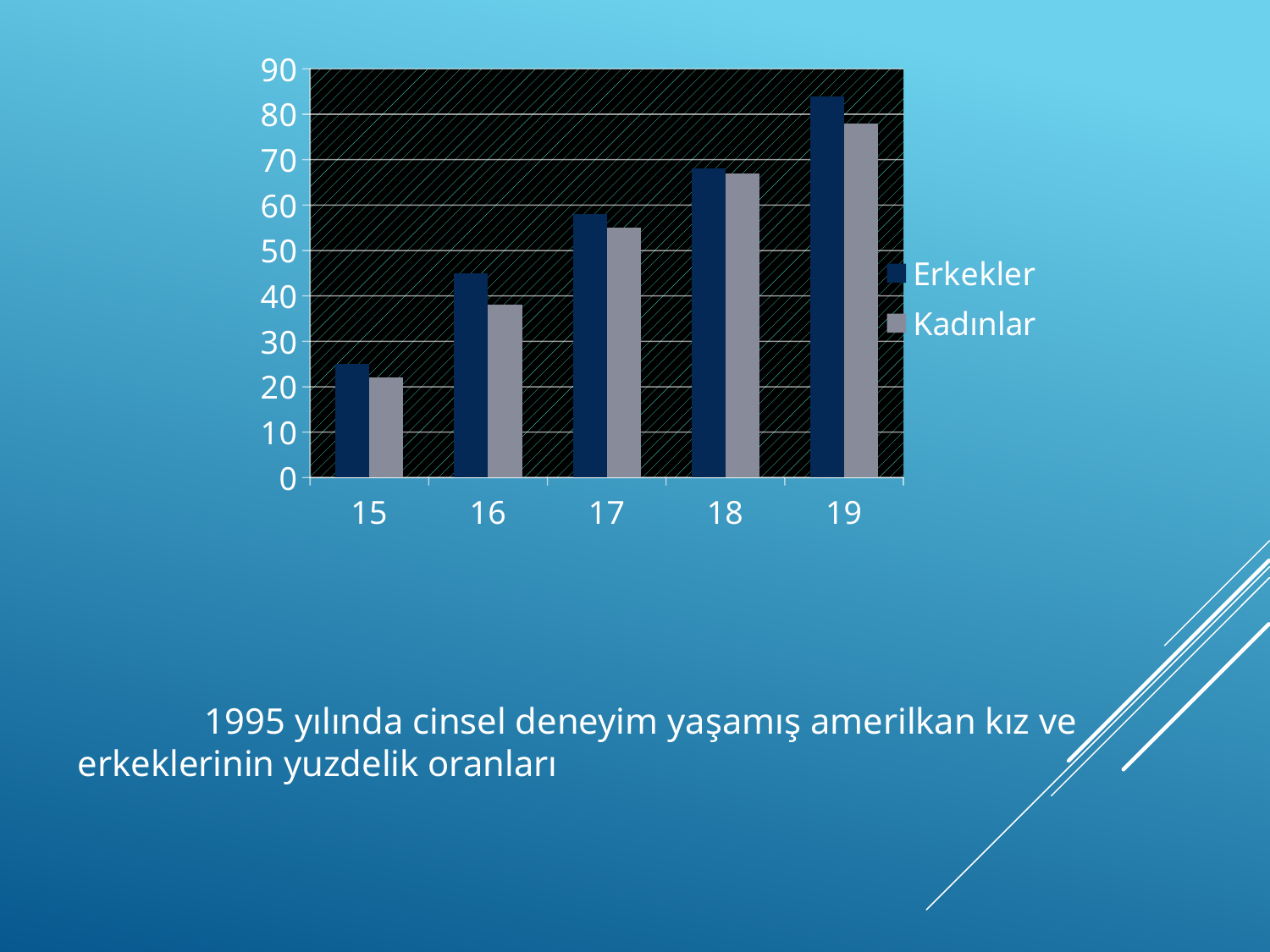
How many series does the legend list? 2 What colour are the Kadınlar bars? grey Is the Erkekler value for age 15 greater or less than 30? less Do the Erkekler values rise or fall as age increases from 15 to 19? rise Is the Kadınlar value for age 19 greater or less than 70? greater How many age categories are shown on the x axis? 5 What kind of chart is shown on the slide? bar chart Is the Erkekler value for age 19 greater or less than 80? greater Which age category has the highest Erkekler value? 19 Which age category has the lowest Kadınlar value? 15 Which series are listed in the legend? Erkekler and Kadınlar For age 16, which series has the larger value, Erkekler or Kadınlar? Erkekler